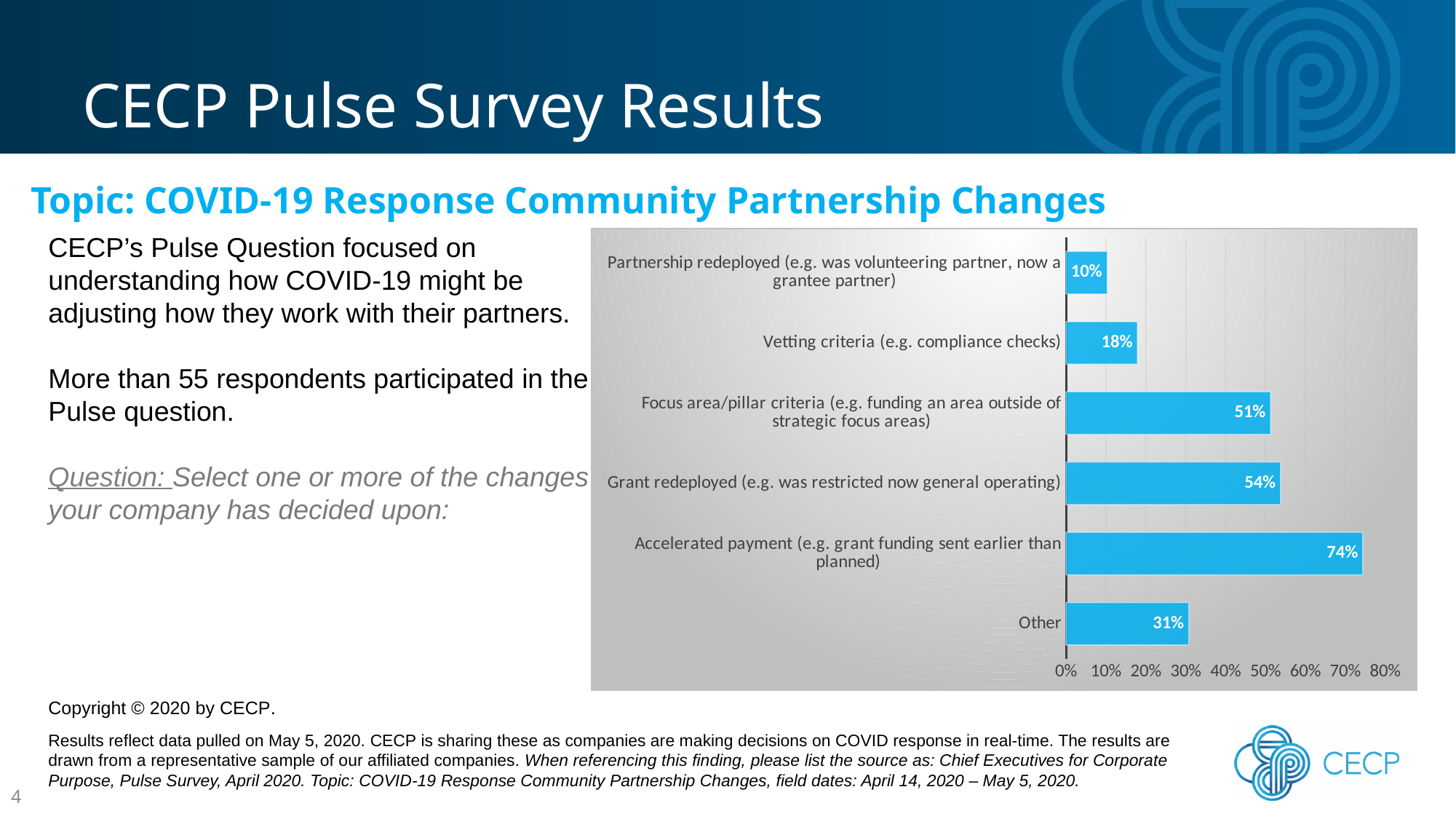
What is the value for "Vetting criteria (e.g. compliance checks)"? 18% Which category has the highest value? Accelerated payment (e.g. grant funding sent earlier than planned) What percentage of respondents selected "Accelerated payment (e.g. grant funding sent earlier than planned)"? 74% What kind of chart is shown on the slide? Bar chart What is the maximum value shown on the chart's horizontal axis? 80% What is the value for "Other"? 31% What is the difference between the values for "Grant redeployed" and "Focus area/pillar criteria"? 3% How many categories are shown in the chart? 6 Which category has the lowest value? Partnership redeployed (e.g. was volunteering partner, now a grantee partner) Which is larger: the value for "Other" or the value for "Vetting criteria"? Other Is the value for "Focus area/pillar criteria" greater or less than 40%? greater What is the difference between the highest and lowest values in the chart? 64%